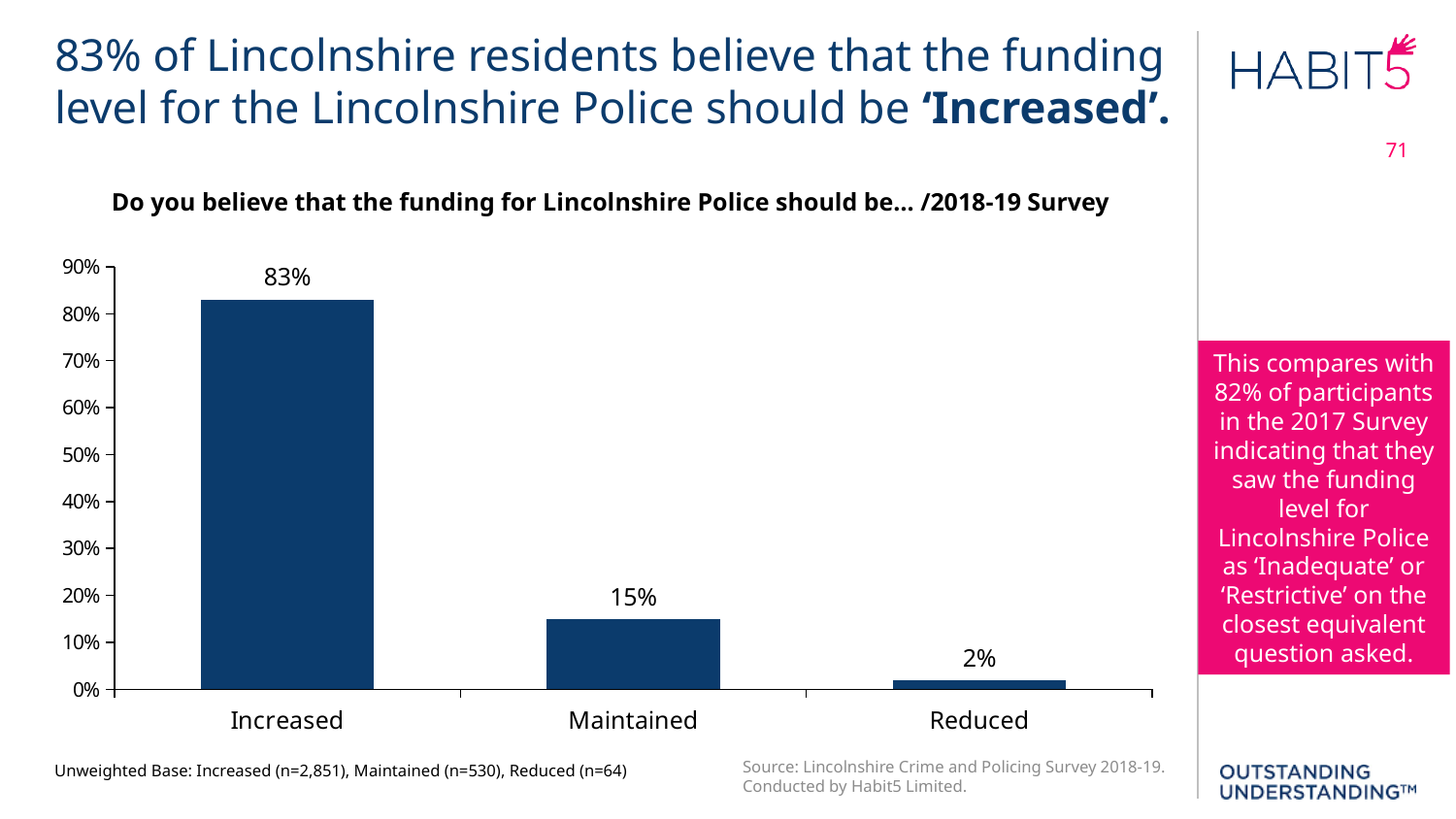
Which is larger, the value for Maintained or the value for Reduced? Maintained Which category has the lowest value? Reduced What is the title of the chart? Do you believe that the funding for Lincolnshire Police should be… /2018-19 Survey What percentage of respondents believe funding should be Reduced? 2% Which category has the highest value? Increased What kind of chart is shown on the slide? Bar chart What is the difference between the Maintained and Reduced values? 13% How many categories are shown on the x axis? 3 What percentage of respondents believe funding should be Maintained? 15% What is the difference between the Increased and Maintained values? 68% Is the value for Increased greater or less than 80%? greater What percentage of respondents believe funding for Lincolnshire Police should be Increased? 83%